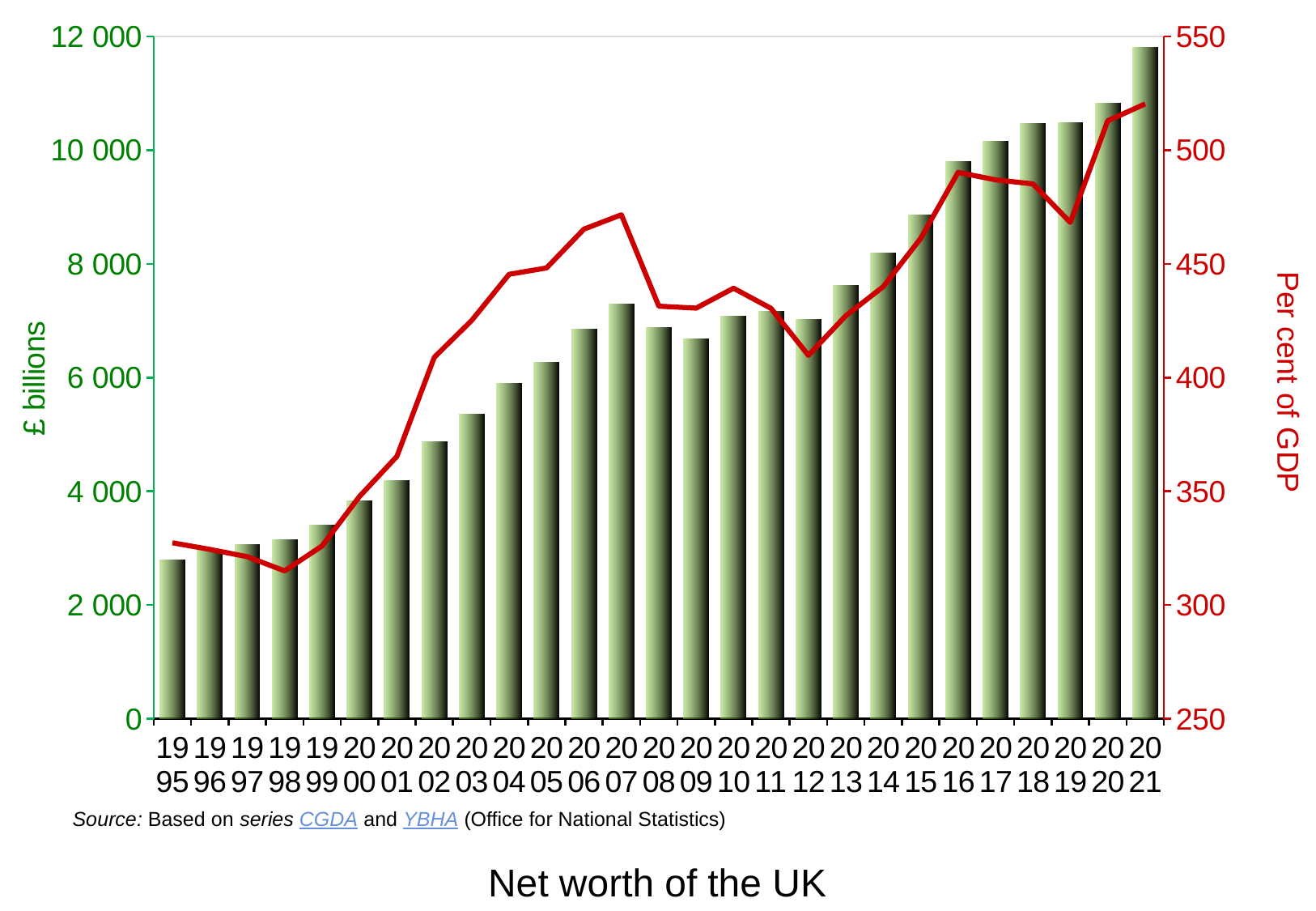
In which year is the per cent of GDP line at its lowest point? 1998 What is the title of the chart? Net worth of the UK Which year has the tallest bar for net worth in £ billions? 2021 Which year has a taller net worth bar, 2007 or 2009? 2007 Is the per cent of GDP line value for 2012 greater or less than 450? less How many years are plotted along the x axis? 27 Is the net worth bar for 2021 greater or less than 10 000 £ billions? greater Do the net worth bars generally rise or fall from 1995 to 2021? rise Is the net worth bar for 1995 greater or less than 4 000 £ billions? less What kind of chart is shown on the slide? A combined bar and line chart Which year has the shortest bar for net worth in £ billions? 1995